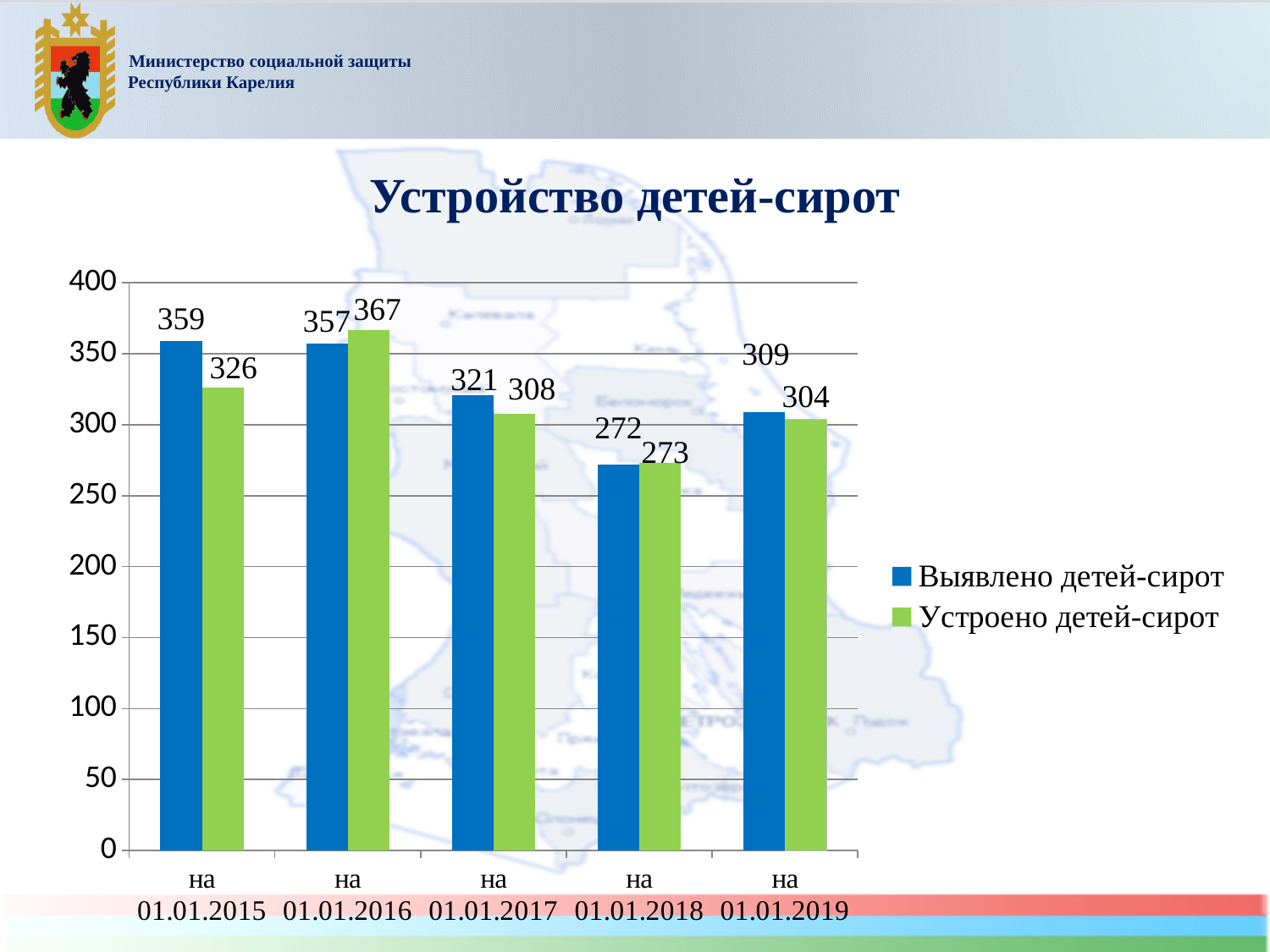
How many dates are shown on the x axis? 5 What kind of chart is shown on the slide? bar chart What is the value of 'Устроено детей-сирот' for 'на 01.01.2018'? 273 What is the title of the chart? Устройство детей-сирот Is the value of 'Выявлено детей-сирот' for 'на 01.01.2019' greater or less than 300? greater What is the difference between 'Выявлено детей-сирот' and 'Устроено детей-сирот' for 'на 01.01.2015'? 33 What is the value of 'Устроено детей-сирот' for 'на 01.01.2016'? 367 Which date has the lowest value for 'Устроено детей-сирот'? на 01.01.2018 How many series does the legend list? 2 What is the value of 'Выявлено детей-сирот' for 'на 01.01.2015'? 359 Which date has the highest value for 'Выявлено детей-сирот'? на 01.01.2015 Which is larger for 'на 01.01.2016': 'Выявлено детей-сирот' or 'Устроено детей-сирот'? Устроено детей-сирот